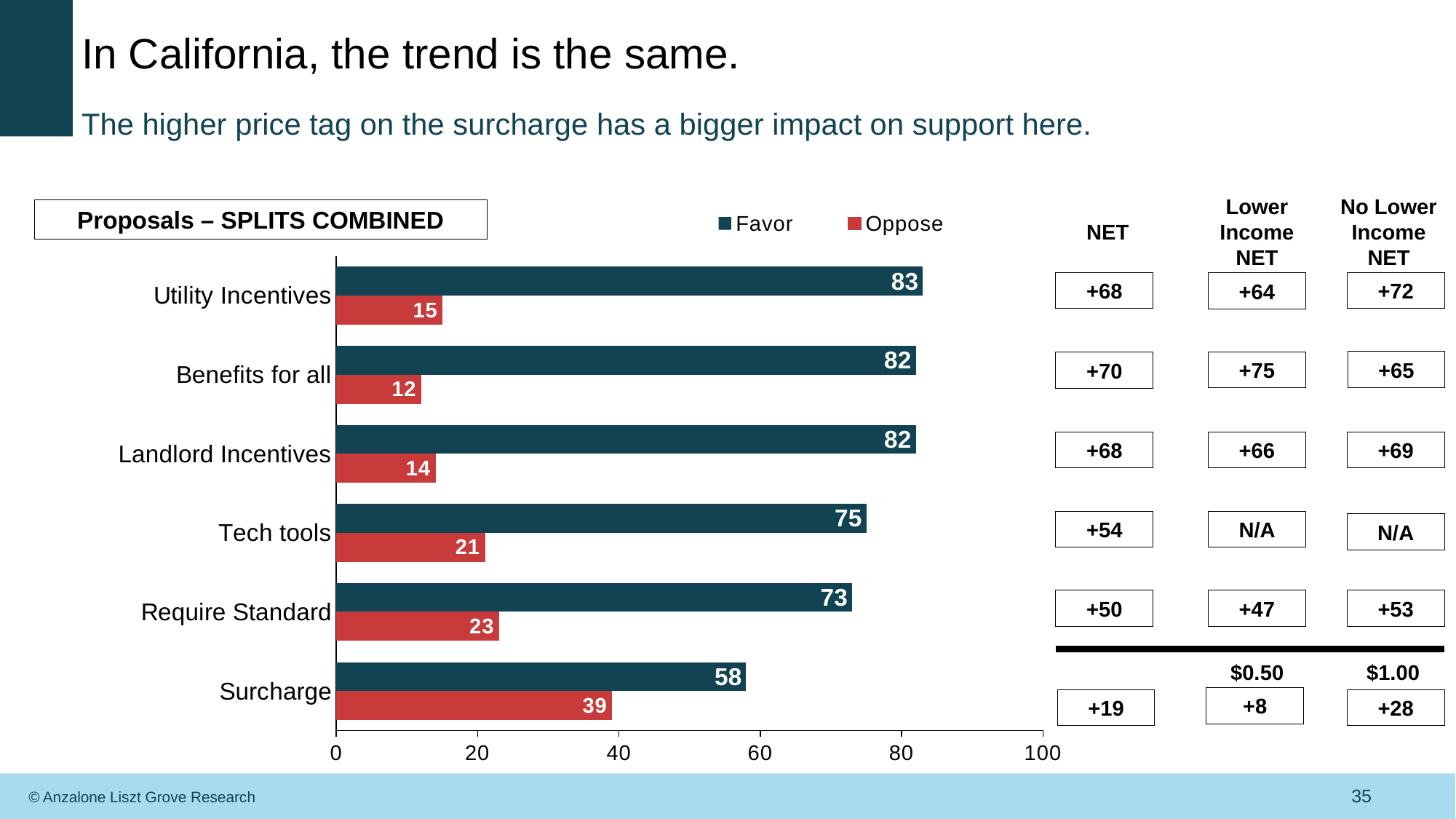
What is the Oppose value for Surcharge? 39 Which category has the lowest Favor value? Surcharge Which category has the lowest Oppose value? Benefits for all What is the difference between the Favor and Oppose values for Require Standard? 50 What is the Favor value for Utility Incentives? 83 What is the Oppose value for Tech tools? 21 What kind of chart is shown on the slide? Bar chart What colour are the Oppose bars? Red Which is larger, the Oppose value for Landlord Incentives or the Oppose value for Require Standard? Require Standard How many series does the legend list? 2 How many categories are shown on the chart? 6 Which category has the highest Favor value? Utility Incentives